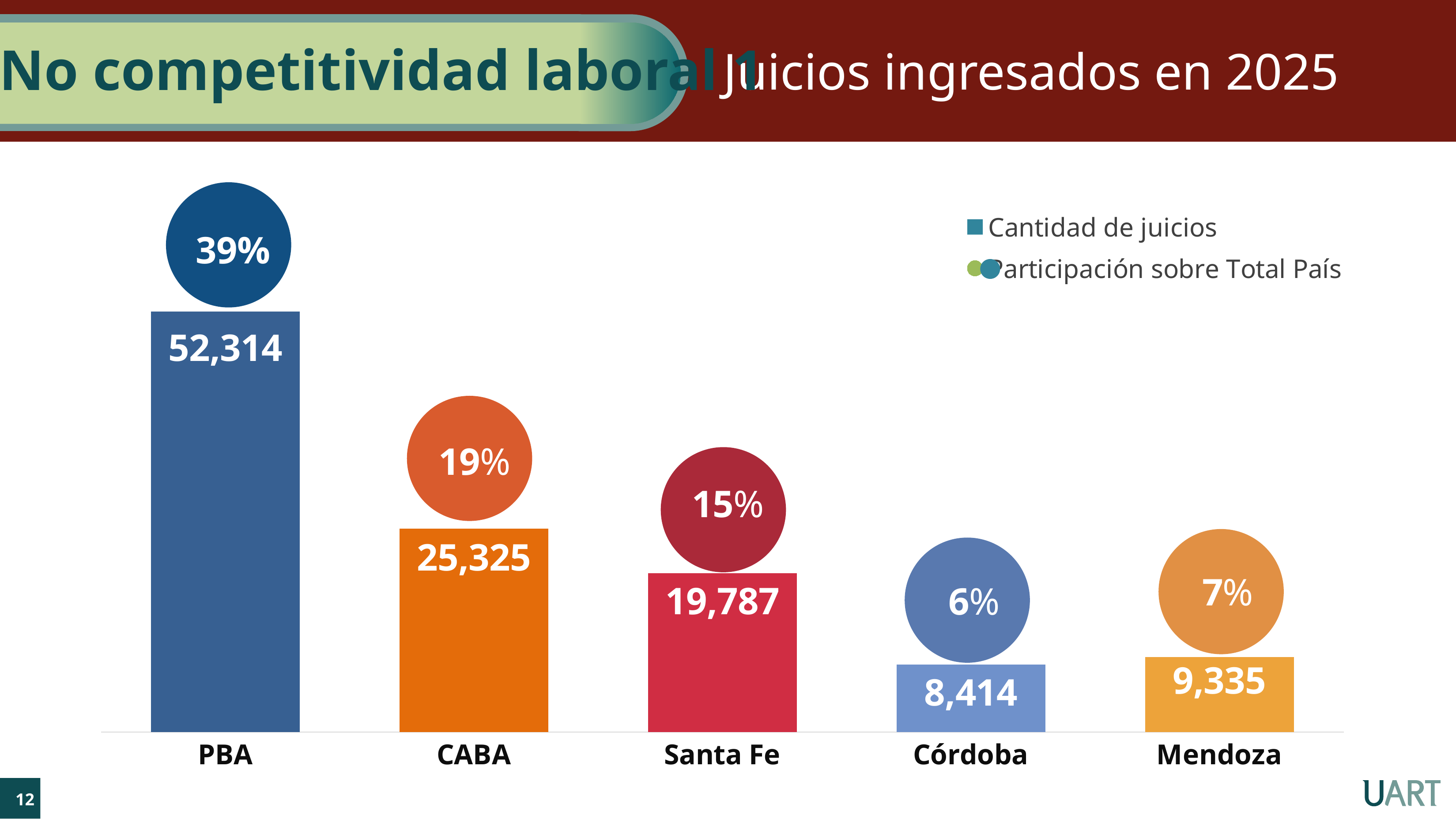
Which province has the highest number of juicios? PBA Which province has the lowest number of juicios? Córdoba What is the Participación sobre Total País for CABA? 19% How many provinces are shown on the x axis? 5 What is the number of juicios (Cantidad de juicios) for PBA? 52,314 How many series does the legend list? 2 What is the number of juicios for Santa Fe? 19,787 What is the Participación sobre Total País for Mendoza? 7% What kind of chart is shown on the slide? Bar chart What is the difference in Participación sobre Total País between PBA and Santa Fe? 24% Which has more juicios, Mendoza or Córdoba? Mendoza What is the difference in number of juicios between PBA and CABA? 26,989